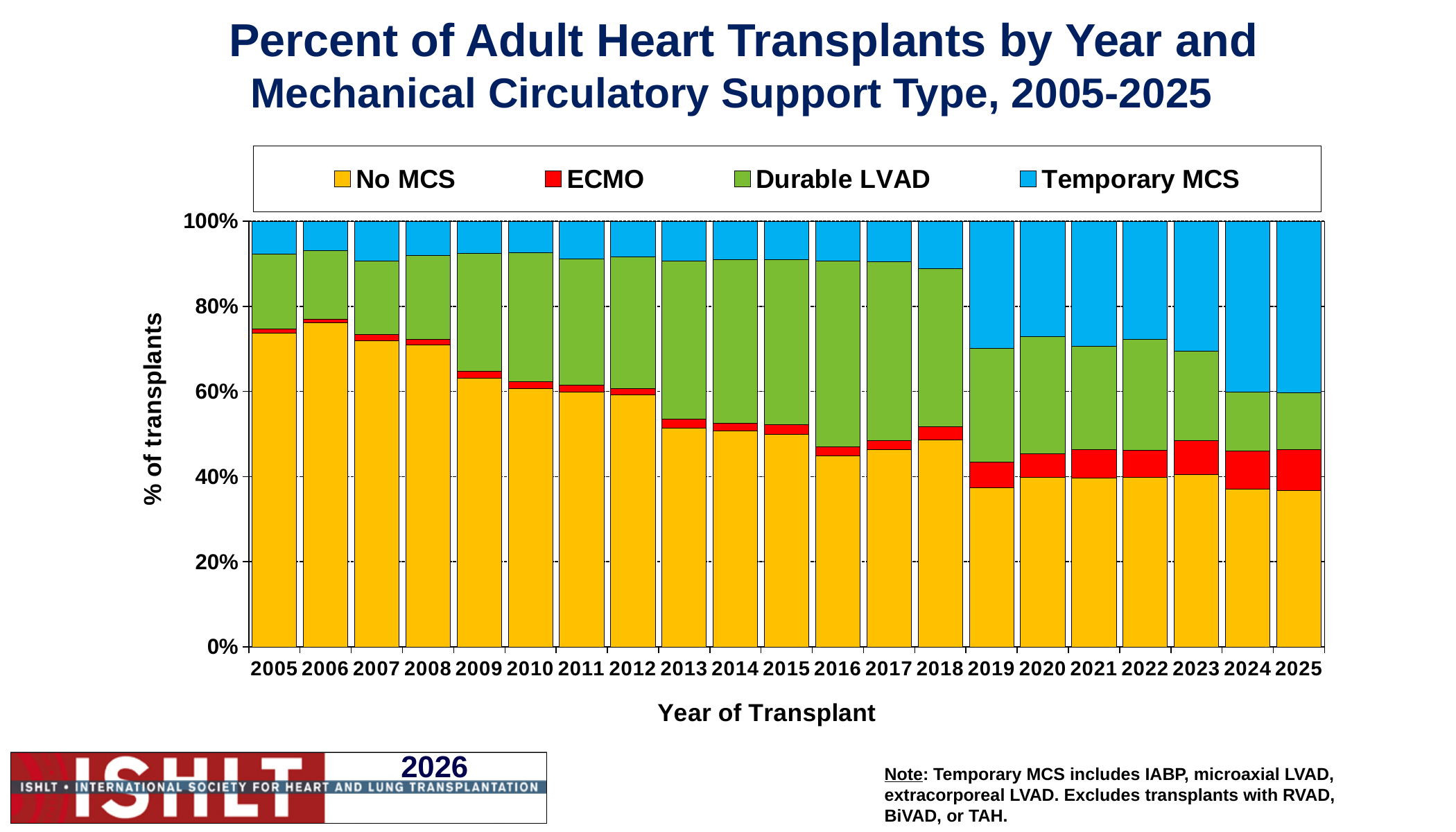
How many series does the legend list? 4 Does the No MCS share rise or fall from 2005 to 2025? Fall What is the label of the y axis? % of transplants Which series is shown in red in the legend? ECMO How many years (bars) are plotted along the x axis? 21 Which year has the larger Temporary MCS share, 2010 or 2024? 2024 Is the No MCS share for 2013 greater or less than 60%? less What kind of chart is shown on the slide? Stacked bar chart In which year is the No MCS share the highest? 2006 What is the total of the stacked bar for 2010? 100% Is the No MCS share for 2025 greater or less than 40%? less Is the No MCS share for 2005 greater or less than 60%? greater